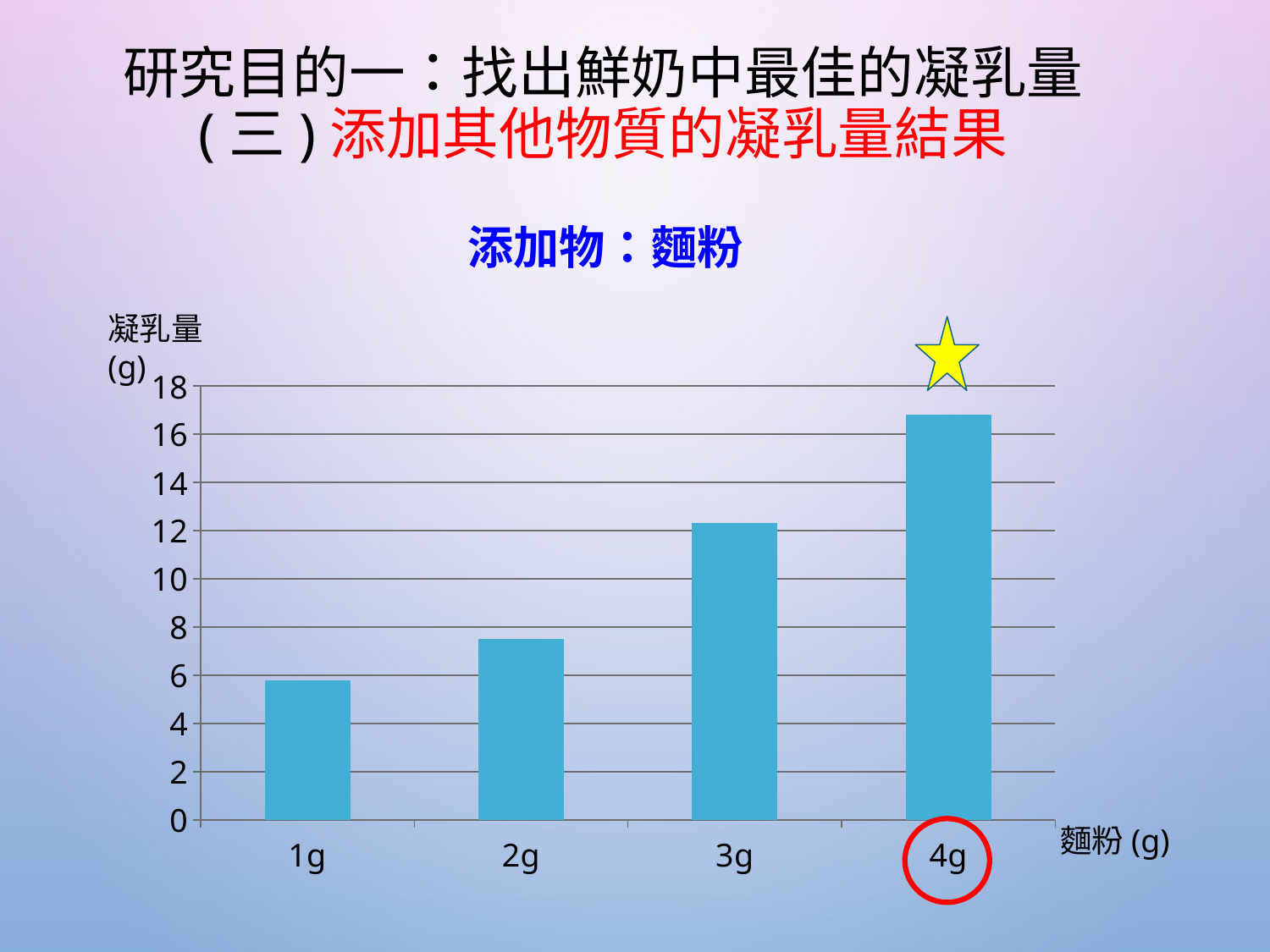
What is the label of the x axis of the chart? 麵粉 (g) Is the value for 1g greater or less than 8? less Is the value for 4g greater or less than 16? greater Which category has the lowest 凝乳量 in the chart? 1g Is the value for 2g greater or less than 6? greater Do the values rise or fall as the amount of 麵粉 increases along the x axis? rise Which is larger, the value for 2g or the value for 3g? 3g What kind of chart is shown on the slide? bar chart How many categories are plotted on the x axis of the chart? 4 What is the title shown above the chart? 添加物：麵粉 Which category has the highest 凝乳量 in the chart? 4g